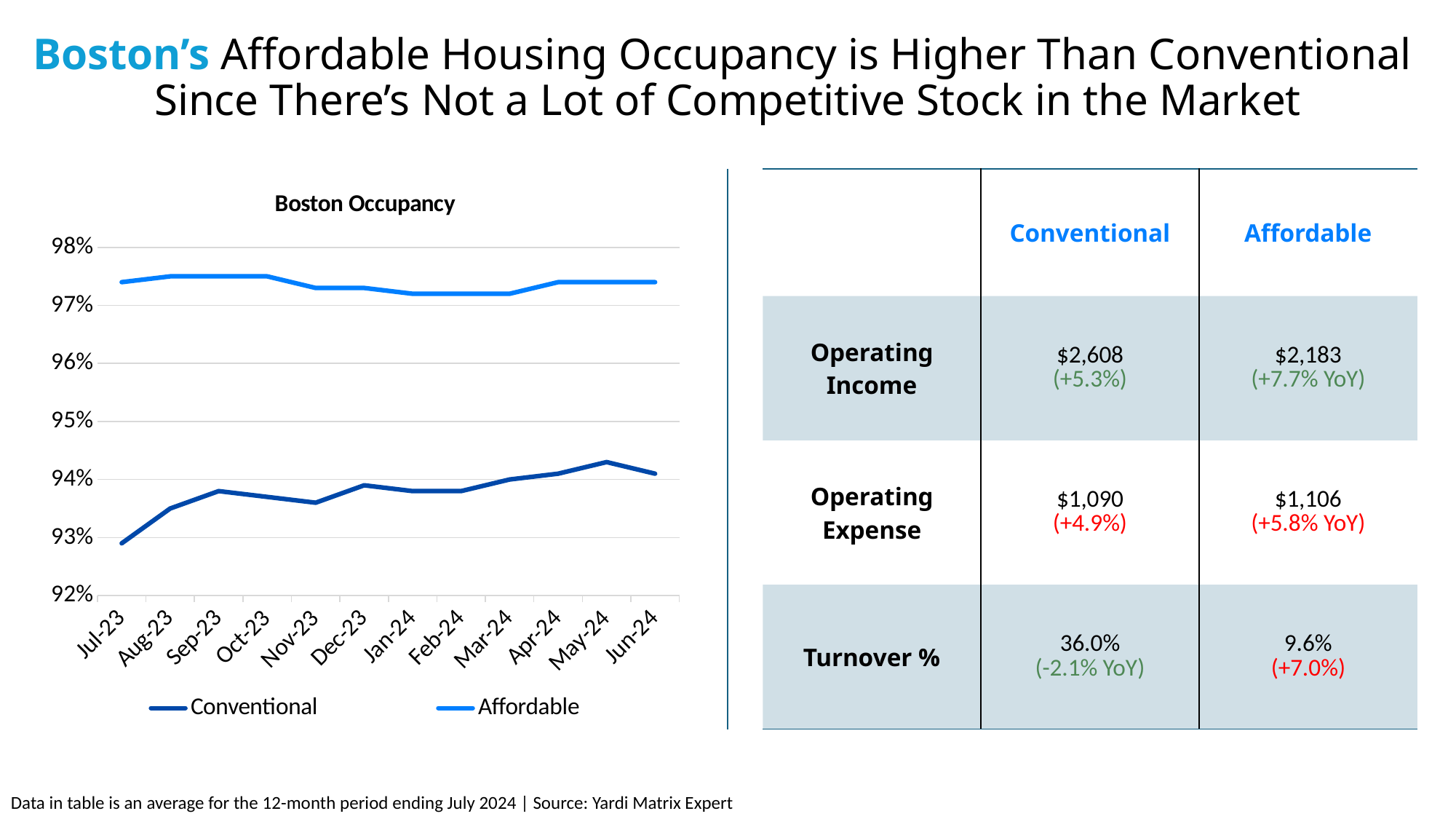
In the Boston Occupancy chart, does the Conventional series generally rise or fall from Jul-23 to Jun-24? rise In the Boston Occupancy chart, is the Affordable value for Jan-24 greater or less than 97%? greater What is the title of the chart on the slide? Boston Occupancy How many series does the legend of the Boston Occupancy chart list? 2 In the Boston Occupancy chart, which series has the higher occupancy in Jul-23, Conventional or Affordable? Affordable In the Boston Occupancy chart, is the Conventional value for Nov-23 greater or less than 94%? less In the Boston Occupancy chart, which month has the highest Conventional occupancy? May-24 In the Boston Occupancy chart, is the Conventional value for Jul-23 greater or less than 93%? less In the Boston Occupancy chart, which month has the lowest Conventional occupancy? Jul-23 How many months are plotted along the x axis of the Boston Occupancy chart? 12 What kind of chart is the Boston Occupancy chart? line chart